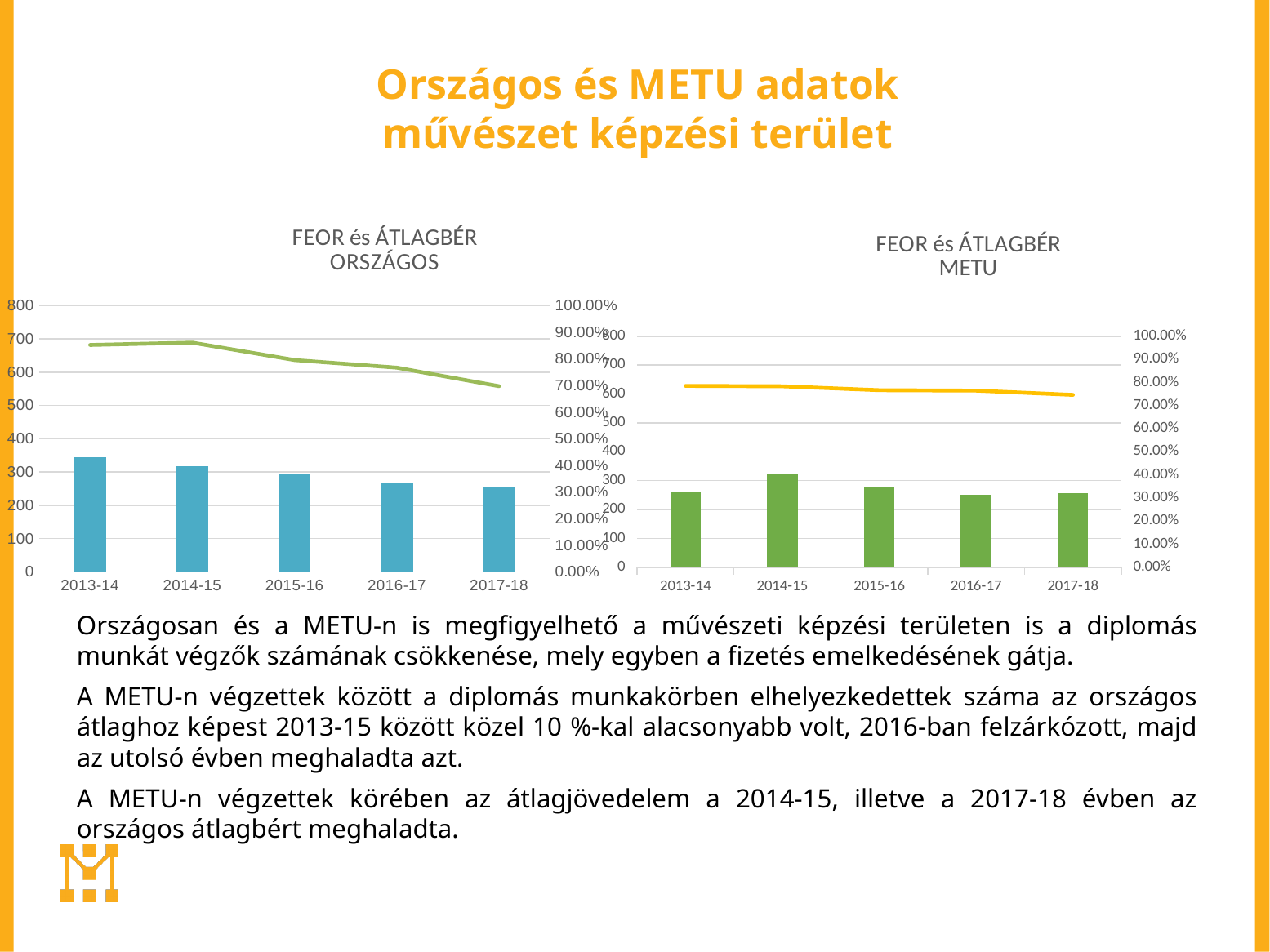
In the FEOR és ÁTLAGBÉR ORSZÁGOS chart, is the bar for 2013-14 greater or less than 300? greater In the FEOR és ÁTLAGBÉR METU chart, which bar is taller: 2014-15 or 2016-17? 2014-15 How many years are shown on the x axis of the FEOR és ÁTLAGBÉR ORSZÁGOS chart? 5 In the FEOR és ÁTLAGBÉR ORSZÁGOS chart, is the bar for 2017-18 greater or less than 300? less What colour are the bars in the FEOR és ÁTLAGBÉR METU chart? green In the FEOR és ÁTLAGBÉR ORSZÁGOS chart, do the bars rise or fall from 2013-14 to 2017-18? fall What kind of chart is the FEOR és ÁTLAGBÉR METU chart? bar chart with a line In the FEOR és ÁTLAGBÉR METU chart, is the bar for 2014-15 greater or less than 300? greater In the FEOR és ÁTLAGBÉR ORSZÁGOS chart, which year has the tallest bar? 2013-14 In the FEOR és ÁTLAGBÉR METU chart, which year has the tallest bar? 2014-15 In the FEOR és ÁTLAGBÉR ORSZÁGOS chart, which bar is taller: 2013-14 or 2015-16? 2013-14